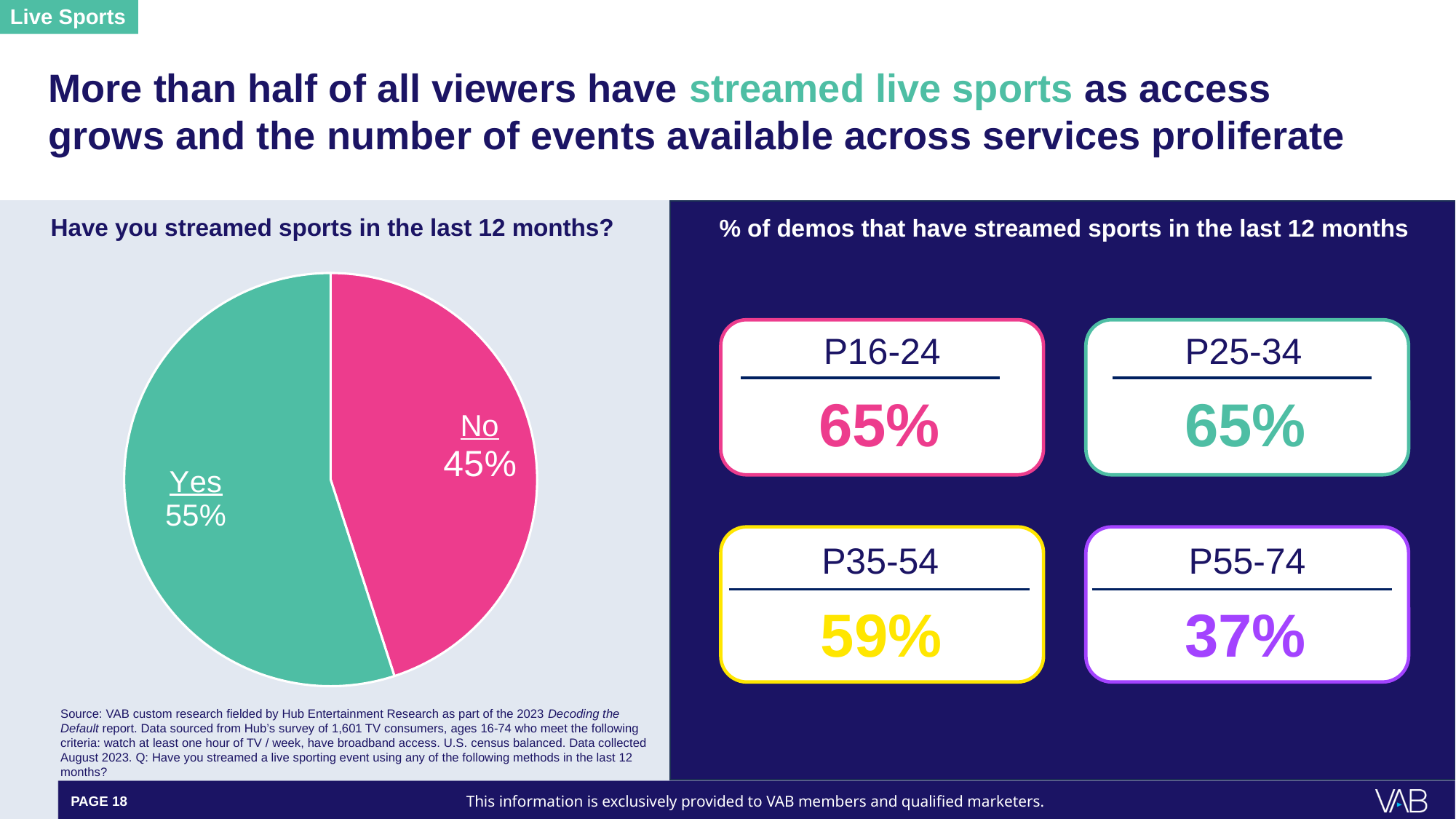
In the pie chart 'Have you streamed sports in the last 12 months?', what percentage answered No? 45% In the pie chart 'Have you streamed sports in the last 12 months?', what colour is the No slice? Pink In the pie chart 'Have you streamed sports in the last 12 months?', which response has the larger share? Yes In the pie chart 'Have you streamed sports in the last 12 months?', how many slices are there? 2 In the panel '% of demos that have streamed sports in the last 12 months', what is the difference between P35-54 and P55-74? 22 percentage points In the pie chart 'Have you streamed sports in the last 12 months?', what percentage answered Yes? 55% In the pie chart 'Have you streamed sports in the last 12 months?', what colour is the Yes slice? Green In the panel '% of demos that have streamed sports in the last 12 months', which demo has the lowest percentage? P55-74 In the pie chart 'Have you streamed sports in the last 12 months?', what is the difference in percentage points between Yes and No? 10 What type of chart is used for 'Have you streamed sports in the last 12 months?' Pie chart In the panel '% of demos that have streamed sports in the last 12 months', what is the value for P35-54? 59% In the pie chart 'Have you streamed sports in the last 12 months?', which response has the smaller share? No